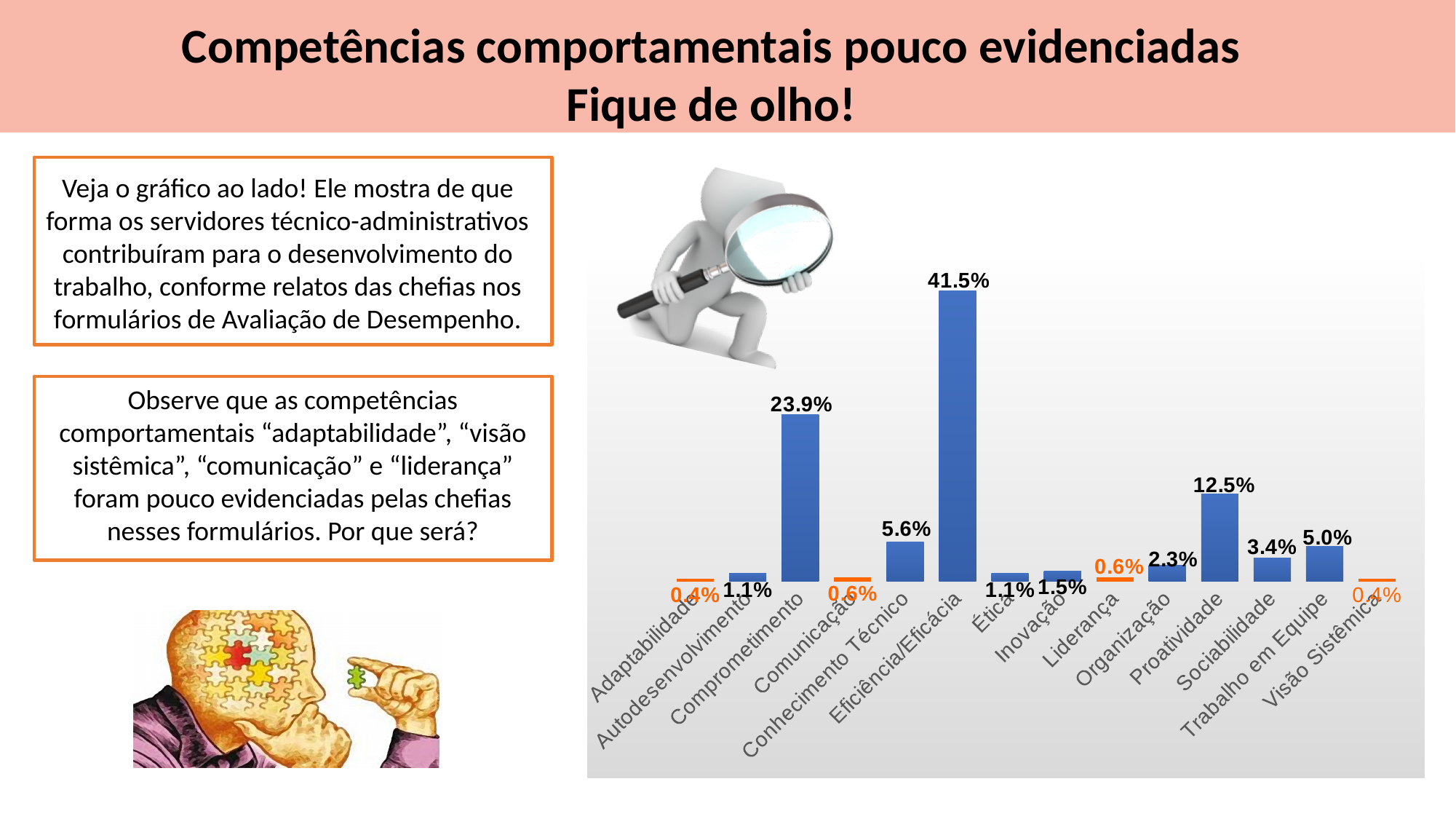
What is the difference between Conhecimento Técnico and Sociabilidade? 2.2% What is the value for Trabalho em Equipe? 5.0% What is the value for Liderança? 0.6% What is the value for Proatividade? 12.5% What is the value for Comprometimento? 23.9% Which is larger, Proatividade or Conhecimento Técnico? Proatividade How many categories are shown in the chart? 14 What kind of chart is shown on the slide? Bar chart What is the value for Eficiência/Eficácia? 41.5% Which category has the highest value? Eficiência/Eficácia Which is larger, Inovação or Organização? Organização What is the difference between Eficiência/Eficácia and Comprometimento? 17.6%